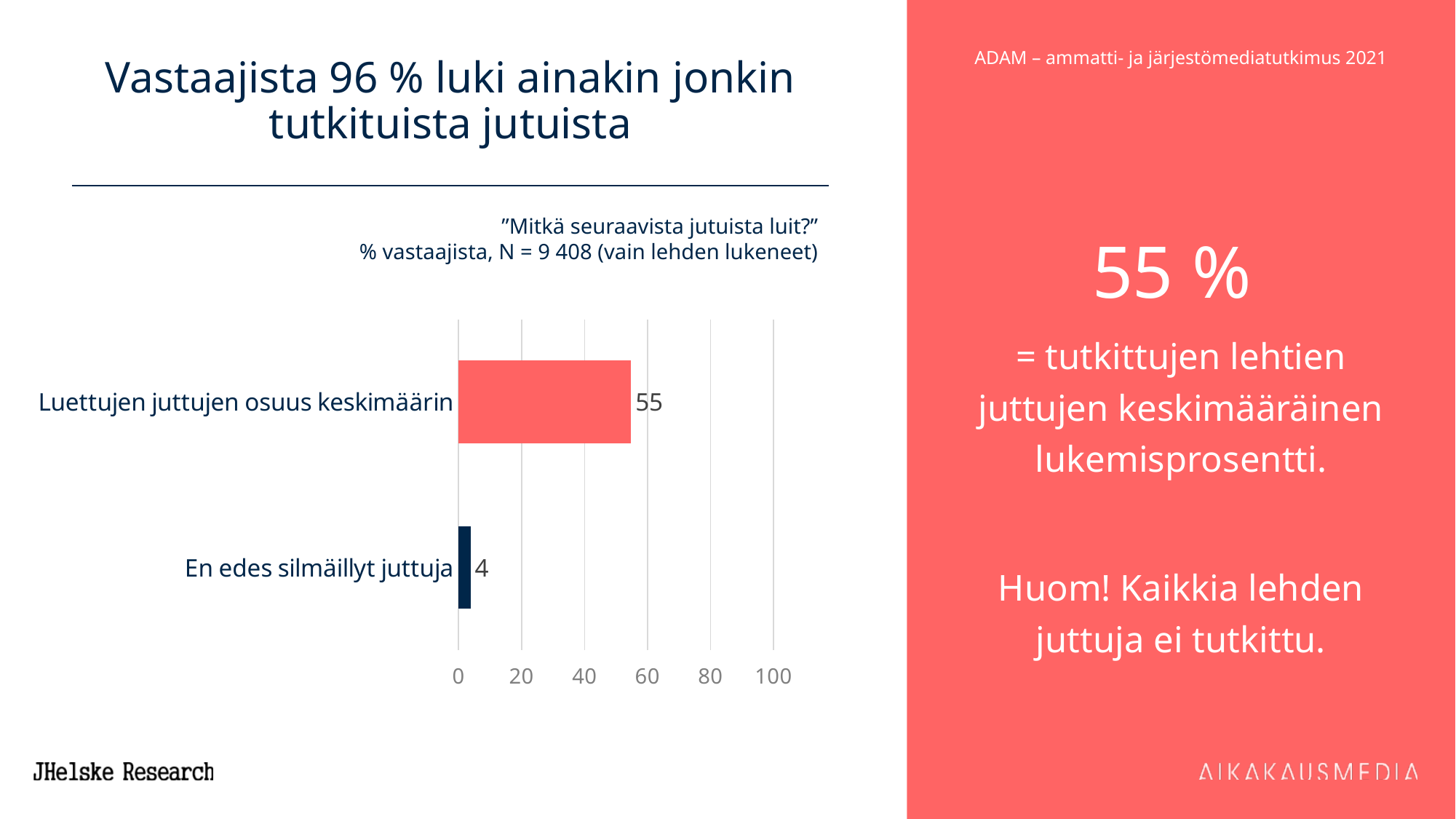
What is the sample size (N) stated in the chart subtitle? 9 408 Which category has the lowest value? En edes silmäillyt juttuja Which is larger: the value for "Luettujen juttujen osuus keskimäärin" or for "En edes silmäillyt juttuja"? Luettujen juttujen osuus keskimäärin Is the value for "En edes silmäillyt juttuja" greater or less than 20? less What is the highest tick value shown on the chart's axis? 100 What is the value for "Luettujen juttujen osuus keskimäärin"? 55 How many categories are shown in the chart? 2 Is the value for "Luettujen juttujen osuus keskimäärin" greater or less than 40? greater What kind of chart is shown on the slide? Bar chart Which category has the highest value? Luettujen juttujen osuus keskimäärin What is the difference between the values for "Luettujen juttujen osuus keskimäärin" and "En edes silmäillyt juttuja"? 51 What is the value for "En edes silmäillyt juttuja"? 4